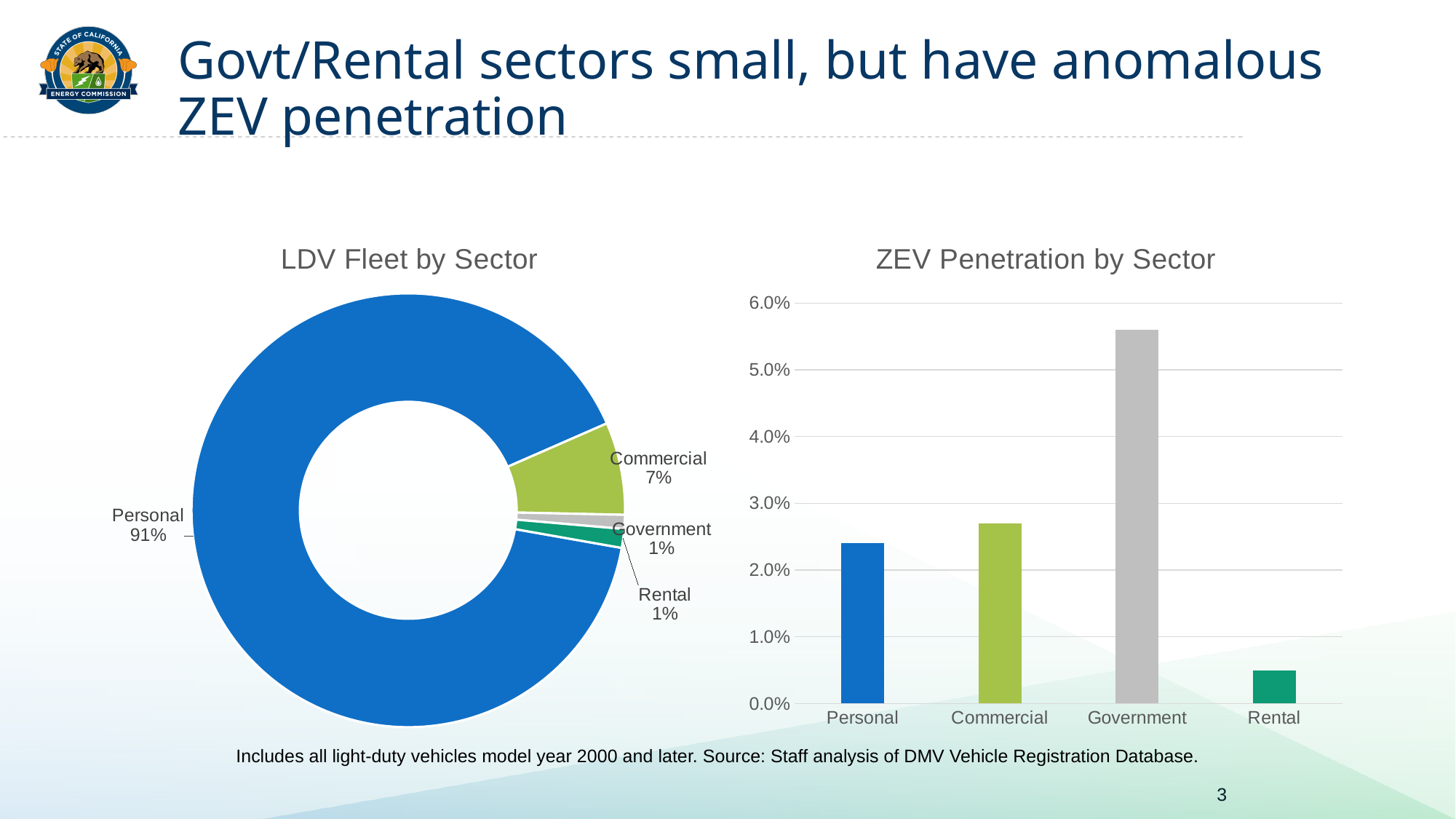
In the ZEV Penetration by Sector chart, is the value for Government greater or less than 5.0%? greater In the LDV Fleet by Sector chart, what share of the fleet is Commercial? 7% In the LDV Fleet by Sector chart, how many sectors are shown? 4 In the ZEV Penetration by Sector chart, is the value for Rental greater or less than 1.0%? less In the ZEV Penetration by Sector chart, which sector has the lowest ZEV penetration? Rental What kind of chart is the ZEV Penetration by Sector chart? Bar chart In the LDV Fleet by Sector chart, what share of the fleet is Government? 1% In the LDV Fleet by Sector chart, what share of the fleet is Personal? 91% In the LDV Fleet by Sector chart, which sector has the largest share? Personal In the ZEV Penetration by Sector chart, which is larger, the value for Commercial or the value for Government? Government What kind of chart is the LDV Fleet by Sector chart? Donut chart In the ZEV Penetration by Sector chart, which sector has the highest ZEV penetration? Government